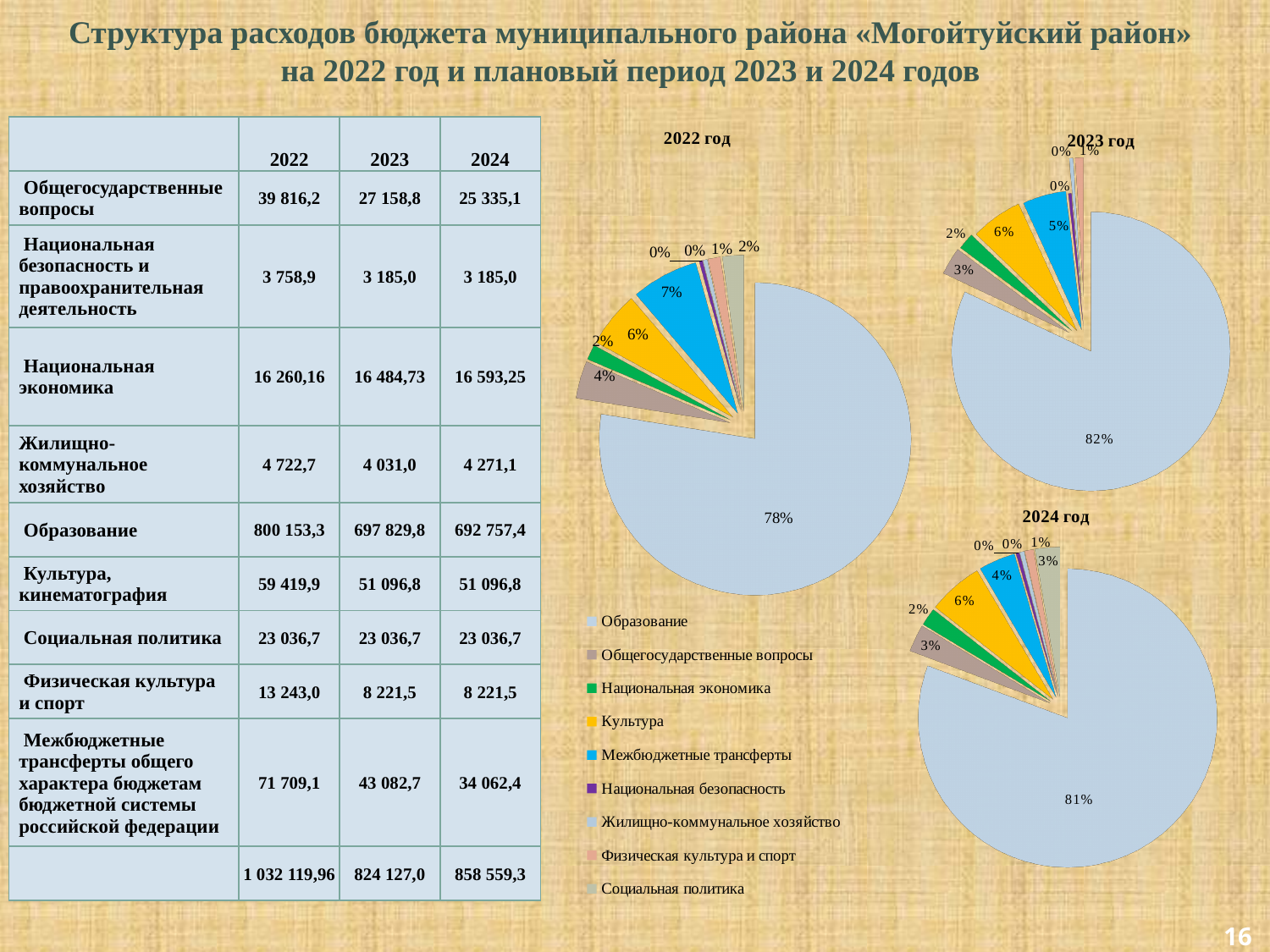
In the 2023 год pie chart, what share does Межбюджетные трансферты have? 5% In the 2024 год pie chart, what share does Образование have? 81% In the 2023 год pie chart, what share does Образование have? 82% In the 2022 год pie chart, what share does Культура have? 6% How many categories does the legend list for the pie charts? 9 In the 2022 год pie chart, which is larger: the share of Культура or the share of Межбюджетные трансферты? Межбюджетные трансферты How many pie charts are on the slide? 3 In the 2022 год pie chart, what share does Межбюджетные трансферты have? 7% In the 2024 год pie chart, what share does Общегосударственные вопросы have? 3% What kind of charts are shown on the slide? Pie charts In the 2022 год pie chart, which category has the largest slice? Образование In the 2022 год pie chart, what share does Образование have? 78%